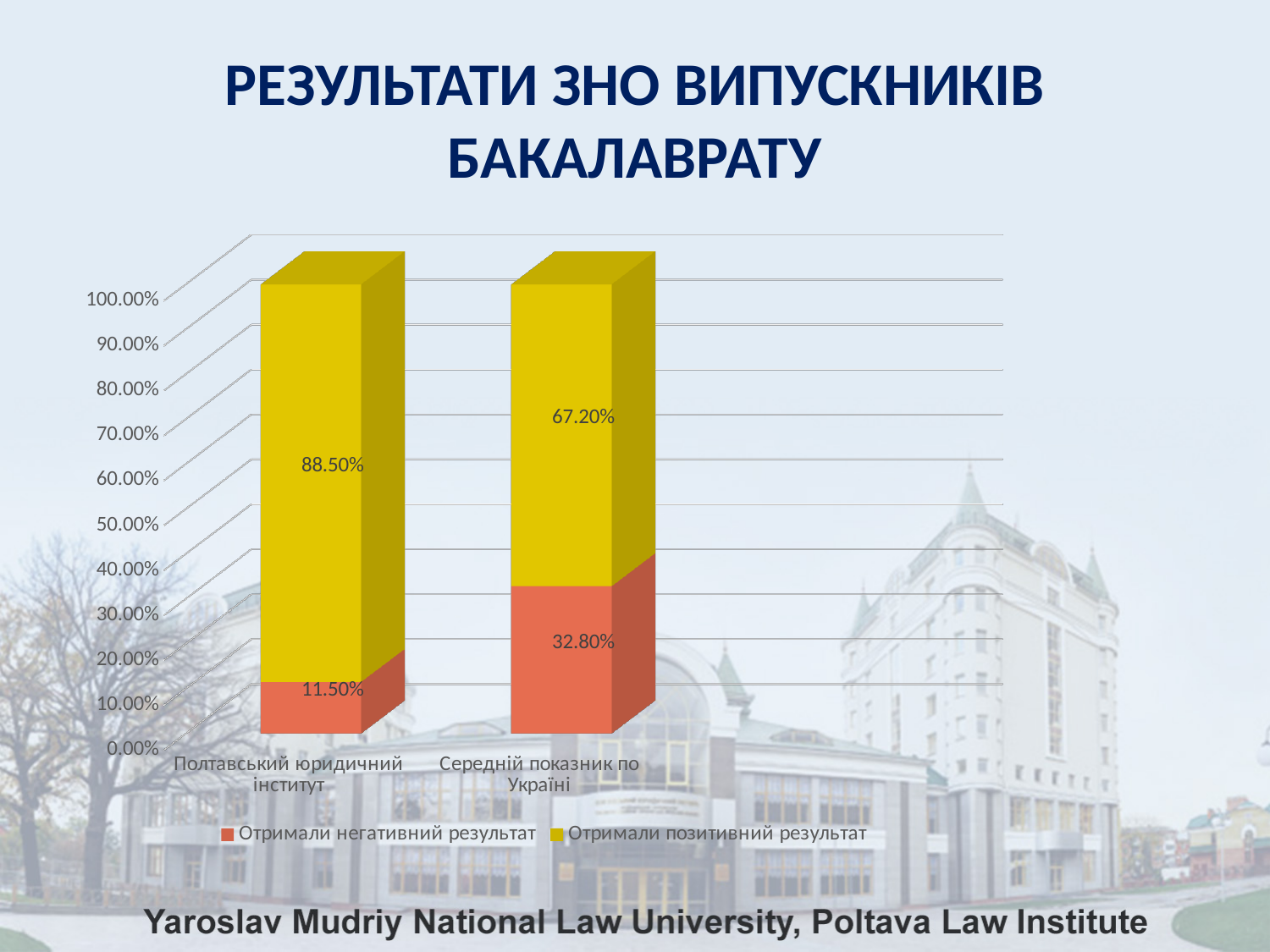
What kind of chart is shown on the slide? Stacked bar chart What is the value for "Отримали позитивний результат" for Полтавський юридичний інститут? 88.50% Which category has the higher value for "Отримали позитивний результат"? Полтавський юридичний інститут Which is larger: "Отримали негативний результат" for Середній показник по Україні or "Отримали негативний результат" for Полтавський юридичний інститут? Середній показник по Україні Which category has the lower value for "Отримали негативний результат"? Полтавський юридичний інститут What is the value for "Отримали негативний результат" for Середній показник по Україні? 32.80% What is the total of the stacked bar for Середній показник по Україні? 100.00% What is the value for "Отримали позитивний результат" for Середній показник по Україні? 67.20% How many categories are shown on the x axis? 2 How many series does the legend list? 2 What is the difference between the "Отримали позитивний результат" values for Полтавський юридичний інститут and Середній показник по Україні? 21.30% What is the value for "Отримали негативний результат" for Полтавський юридичний інститут? 11.50%